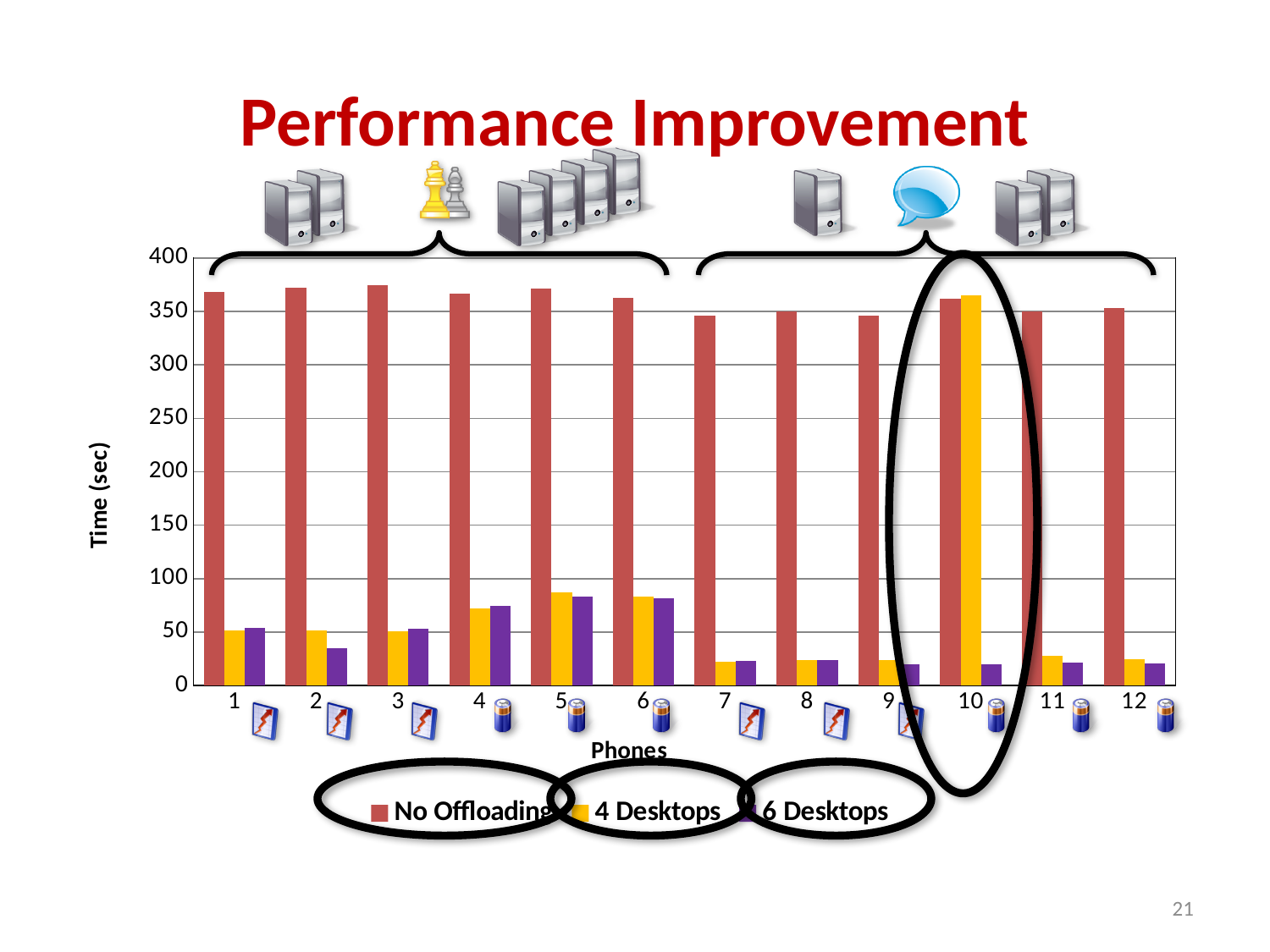
What kind of chart is shown on the slide? bar chart Which phone has the highest 4 Desktops value? 10 How many phones (categories) are shown on the x axis? 12 Is the 6 Desktops value for phone 7 greater or less than 50? less Is the 6 Desktops value for phone 2 greater or less than 50? less Which is larger, the 4 Desktops value for phone 4 or for phone 1? phone 4 What is the title of the chart? Performance Improvement How many series does the legend list? 3 Is the No Offloading value for phone 1 greater or less than 300? greater What is the label of the y axis? Time (sec)